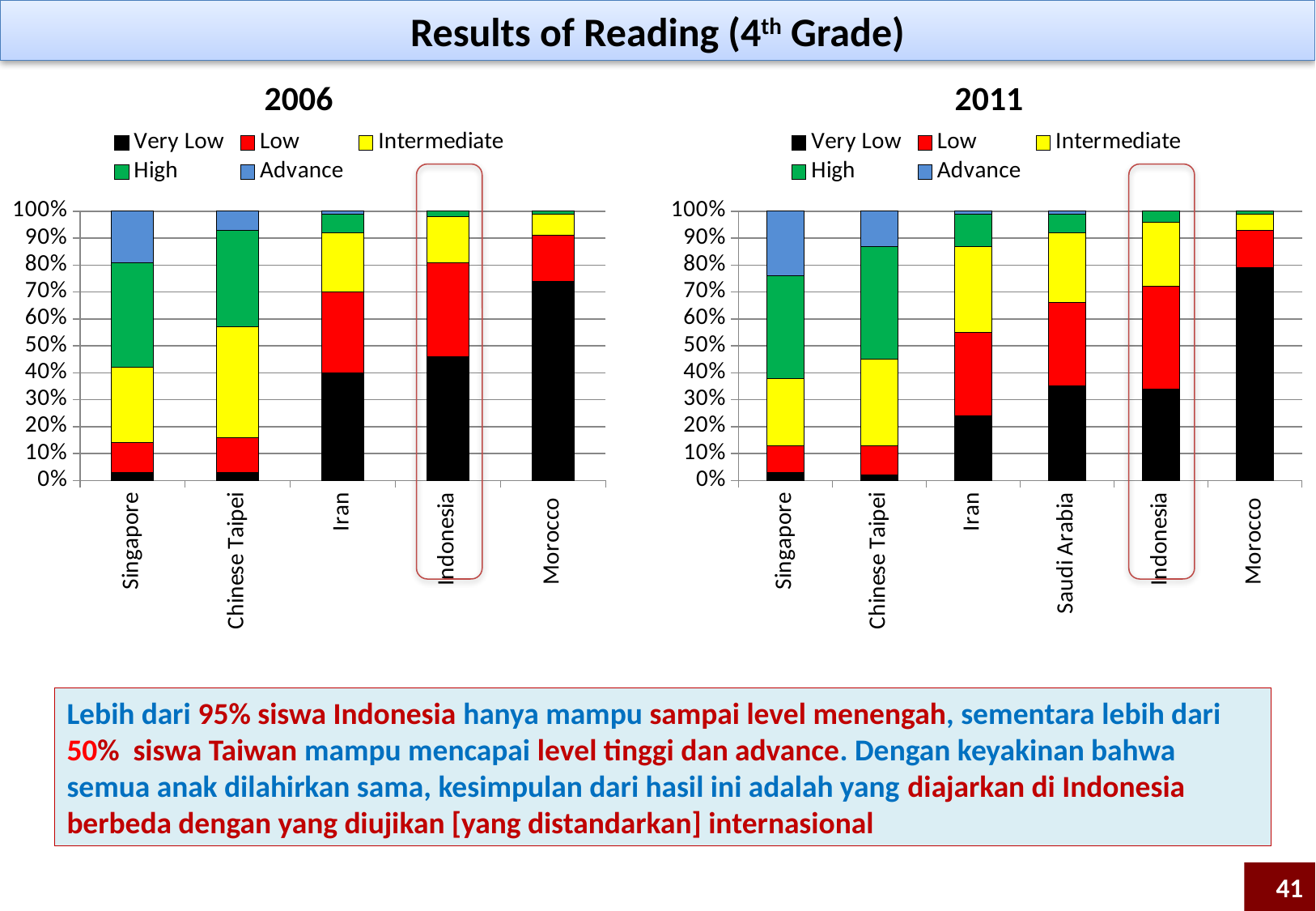
How many countries are shown on the 2006 chart? 5 In the 2006 chart, is the Very Low share for Morocco greater or less than 70%? greater In the 2011 chart, which country has the largest Advance share? Singapore In the 2006 chart, which has the larger Very Low share, Indonesia or Iran? Indonesia How many series does the legend of the 2011 chart list? 5 In the 2006 chart, which country has the largest Very Low share? Morocco How many countries are shown on the 2011 chart? 6 Which country is highlighted with a red outline on both charts? Indonesia In the 2011 chart, which has the larger Very Low share, Morocco or Saudi Arabia? Morocco What kind of chart is the 2006 chart? stacked bar chart In the 2011 chart, is the Very Low share for Iran greater or less than 20%? greater In the 2011 chart, is the Very Low share for Indonesia greater or less than 30%? greater